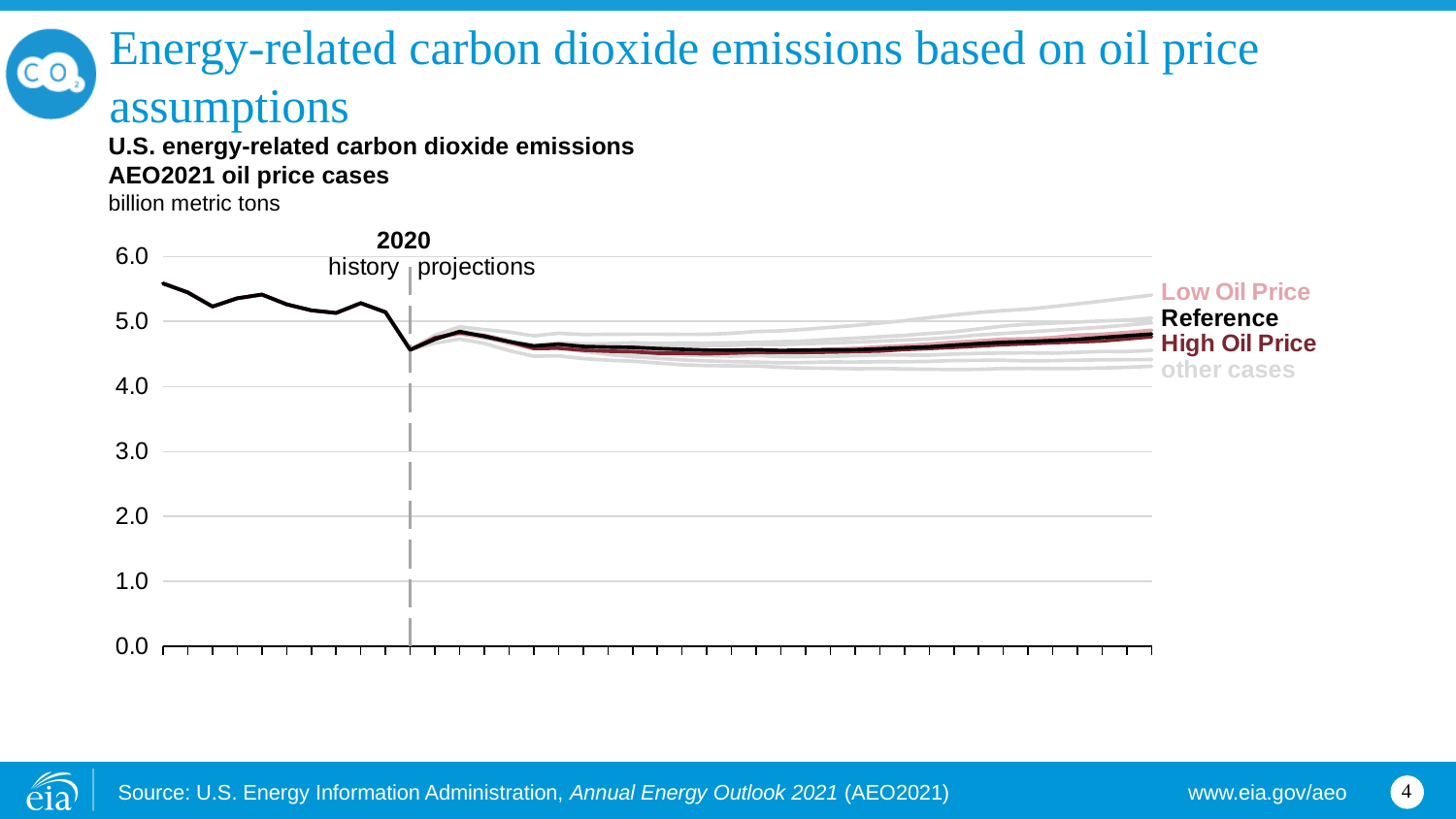
Among the Low Oil Price, Reference and High Oil Price cases, which has the lowest emissions at the end of the projection period? High Oil Price Is the emissions value at the 2020 dividing line greater or less than 5.0? less Over the history period before 2020, do emissions generally rise or fall? fall What year marks the boundary between history and projections on the chart? 2020 Is the Low Oil Price line at the end of the projection period greater or less than 5.0? less How many case labels are listed to the right of the chart? 4 Among the Low Oil Price, Reference and High Oil Price cases, which has the highest emissions at the end of the projection period? Low Oil Price What unit is used for the y axis of the chart? billion metric tons Is the emissions value at the start of the history period greater or less than 5.0? greater What kind of chart is shown on the slide? line chart At the end of the projection period, which is larger: the Low Oil Price case or the High Oil Price case? Low Oil Price